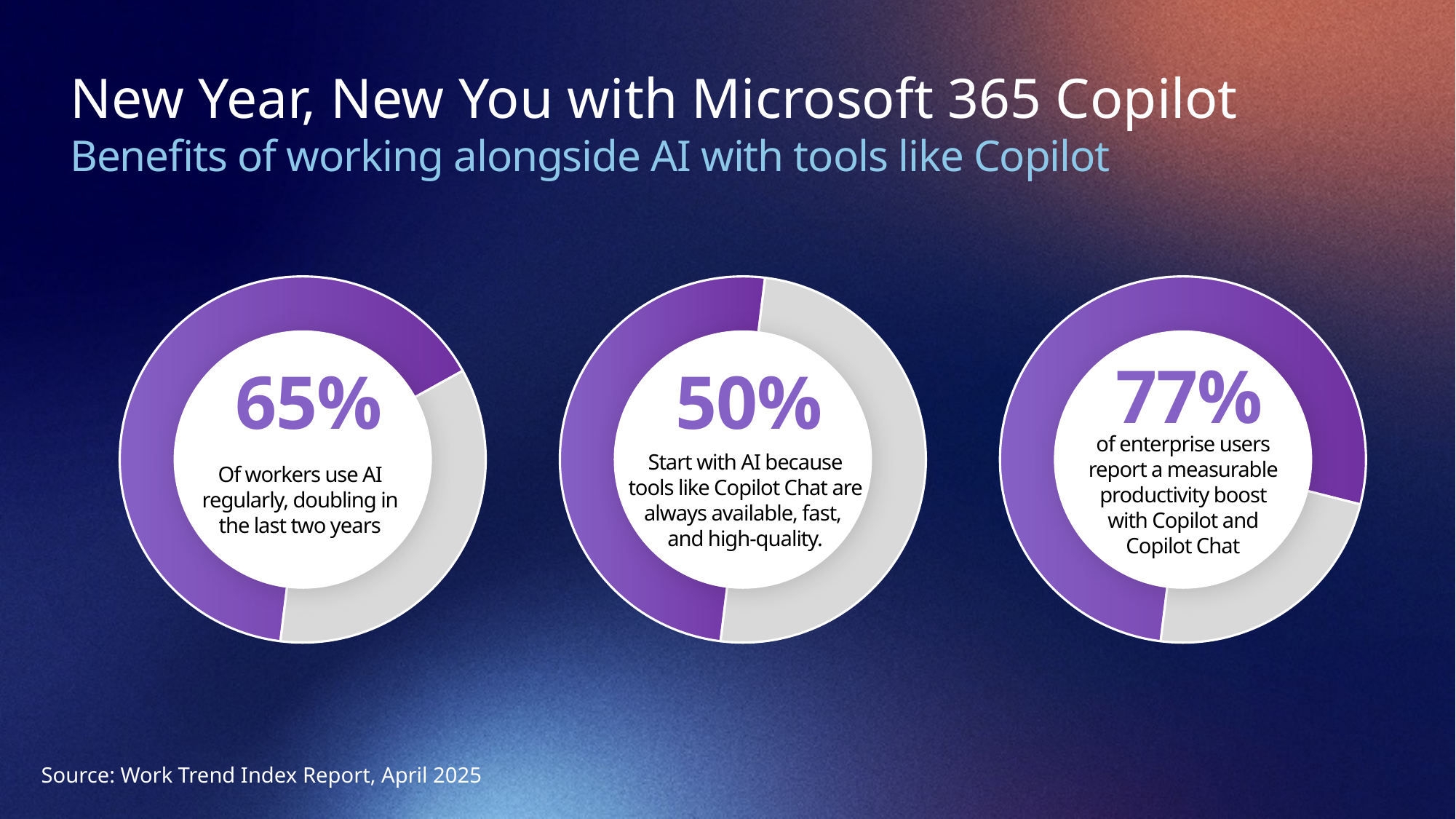
What is the difference between the percentage in the left donut chart (65%) and the middle donut chart (50%)? 15 percentage points What percentage is shown in the right donut chart about enterprise users reporting a measurable productivity boost? 77% What source is cited for the data in the charts? Work Trend Index Report, April 2025 How many donut charts are shown on the slide? 3 What percentage is shown in the left donut chart about workers using AI regularly? 65% What is the difference between the percentage in the right donut chart (77%) and the left donut chart (65%)? 12 percentage points Which of the three donut charts shows the lowest percentage? The middle chart (50%) What percentage is shown in the middle donut chart about starting with AI because tools like Copilot Chat are always available? 50% Which is larger: the percentage in the left donut chart or the percentage in the middle donut chart? The left chart (65%) Which of the three donut charts shows the highest percentage? The right chart (77%) What kind of chart is used to display the three percentages on the slide? Donut chart What colour is used for the filled portion of each donut chart? Purple